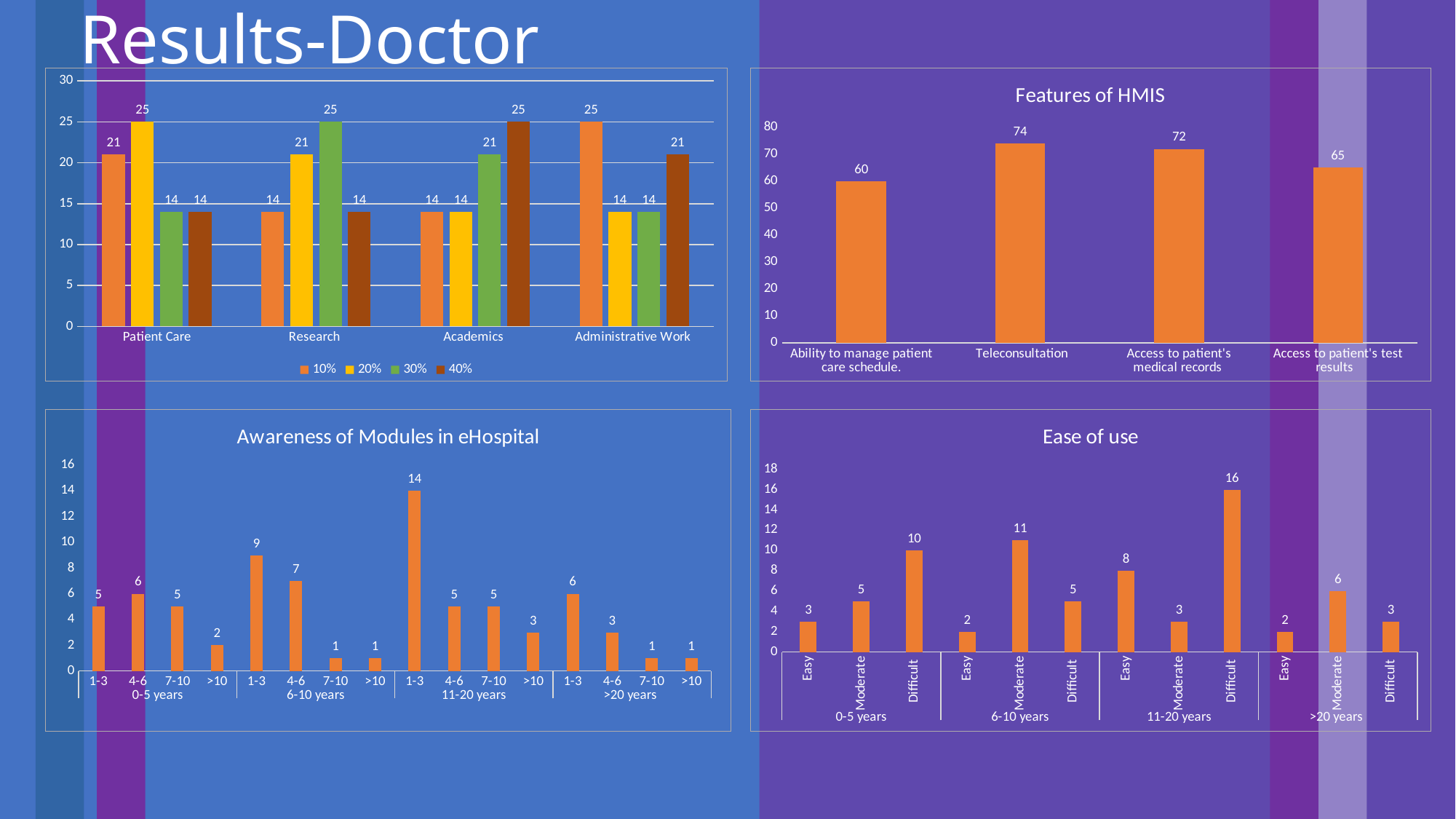
In the 'Features of HMIS' chart, what is the difference between Teleconsultation and Access to patient's test results? 9 In the 'Ease of use' chart, is the value for Moderate in the 6-10 years group larger than the value for Moderate in the >20 years group? Yes In the 'Features of HMIS' chart, what is the value for Teleconsultation? 74 In the 'Ease of use' chart, what is the value for Difficult in the 11-20 years group? 16 In the top-left chart, which series has the highest value for Administrative Work? 10% In the 'Features of HMIS' chart, which feature has the lowest value? Ability to manage patient care schedule. What kind of chart is 'Ease of use'? Bar chart In the 'Awareness of Modules in eHospital' chart, which bar in the 6-10 years group is the highest? 1-3 In the top-left chart, how many series does the legend list? 4 In the 'Features of HMIS' chart, how many features are plotted? 4 In the top-left chart, what is the value of the 30% series for Research? 25 In the 'Awareness of Modules in eHospital' chart, what is the value for 1-3 in the 11-20 years group? 14